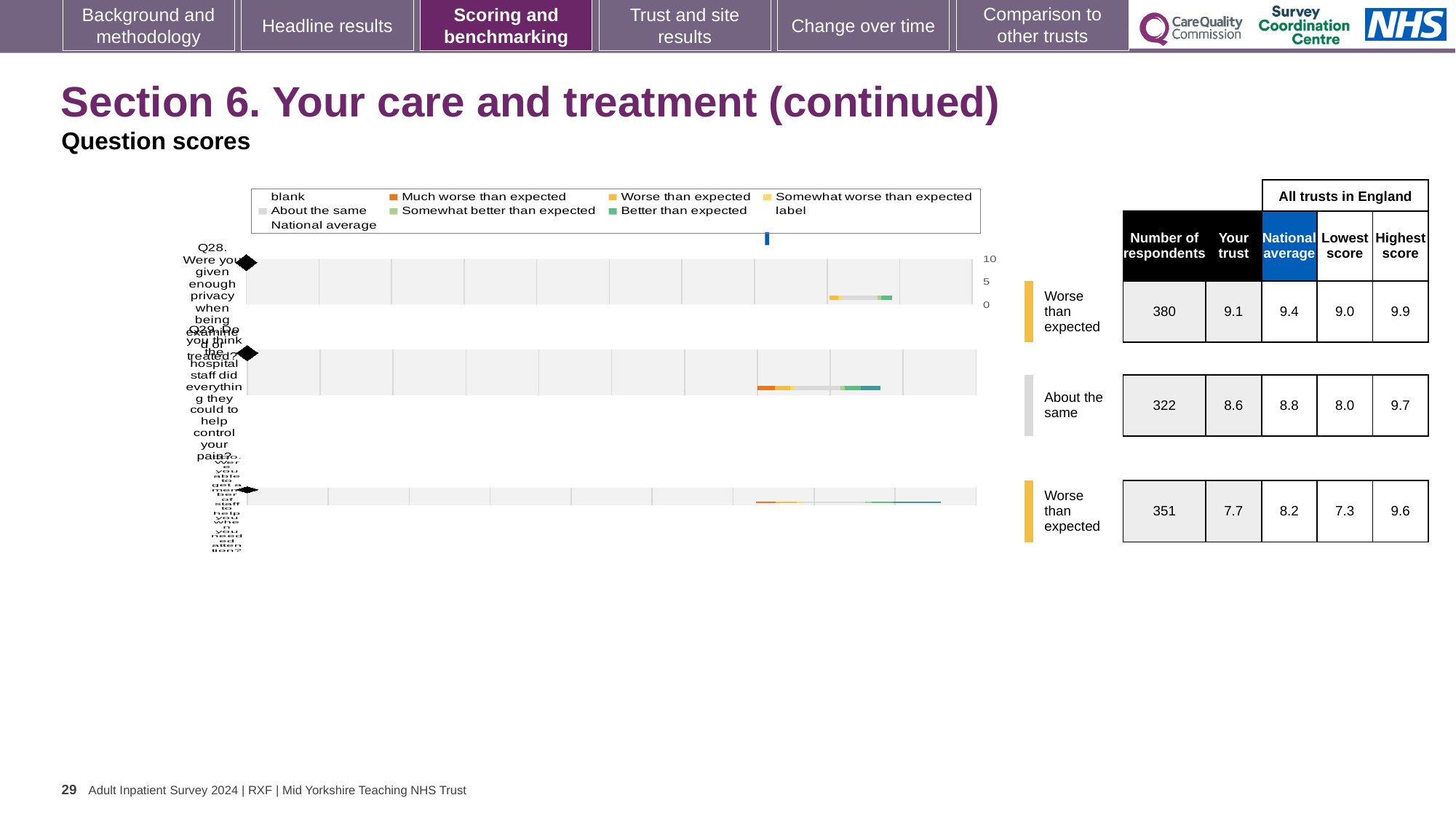
What is the difference between the national average and the 'Your trust' score for Q30? 0.5 Which question has the lowest 'Your trust' score? Q30 What benchmark category is Q29 assigned to? About the same Which question has the highest 'Your trust' score? Q28 What is the national average score for Q30? 8.2 What kind of chart is used to show the question scores? Bar chart How many respondents are shown for Q28 (privacy when being examined or treated)? 380 What is the highest score across all trusts in England for Q29? 9.7 How many questions are plotted on the slide? 3 What is the lowest score across all trusts in England for Q28? 9.0 What is the 'Your trust' score for Q29 (staff did everything to help control your pain)? 8.6 For Q28, which is larger: the 'Your trust' score or the national average? National average